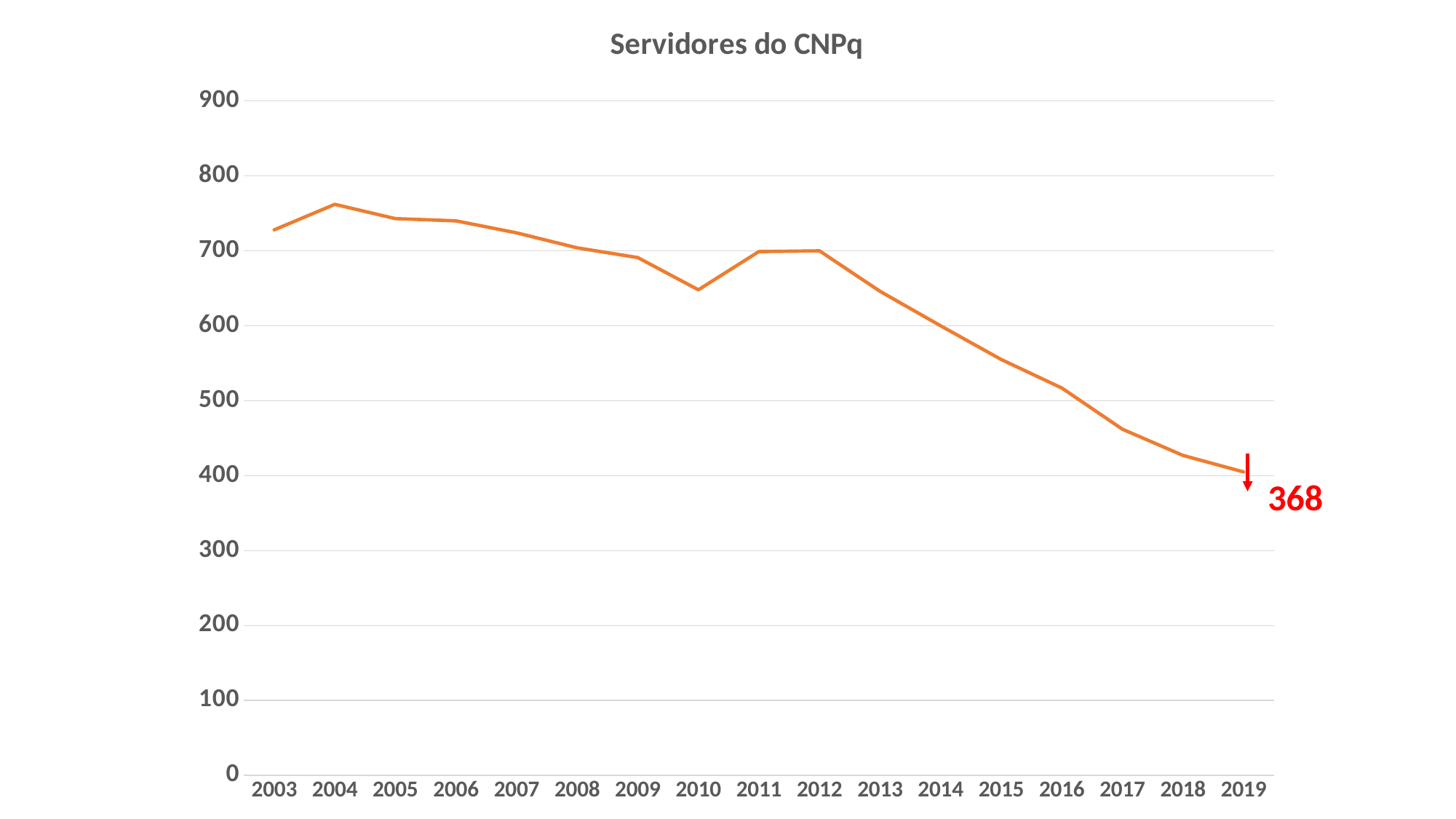
Is the value for 2010 greater or less than 700? less Overall, do the values rise or fall from 2003 to 2019? fall What number is written in red next to the arrow at the end of the line? 368 Is the value for 2015 greater or less than 500? greater What kind of chart is shown on the slide? line chart Which year has the lowest value on the line? 2019 How many years are plotted along the x axis? 17 What is the title of the chart? Servidores do CNPq Which year has the larger value, 2010 or 2011? 2011 Which year has the highest value on the line? 2004 Is the value for 2017 greater or less than 500? less